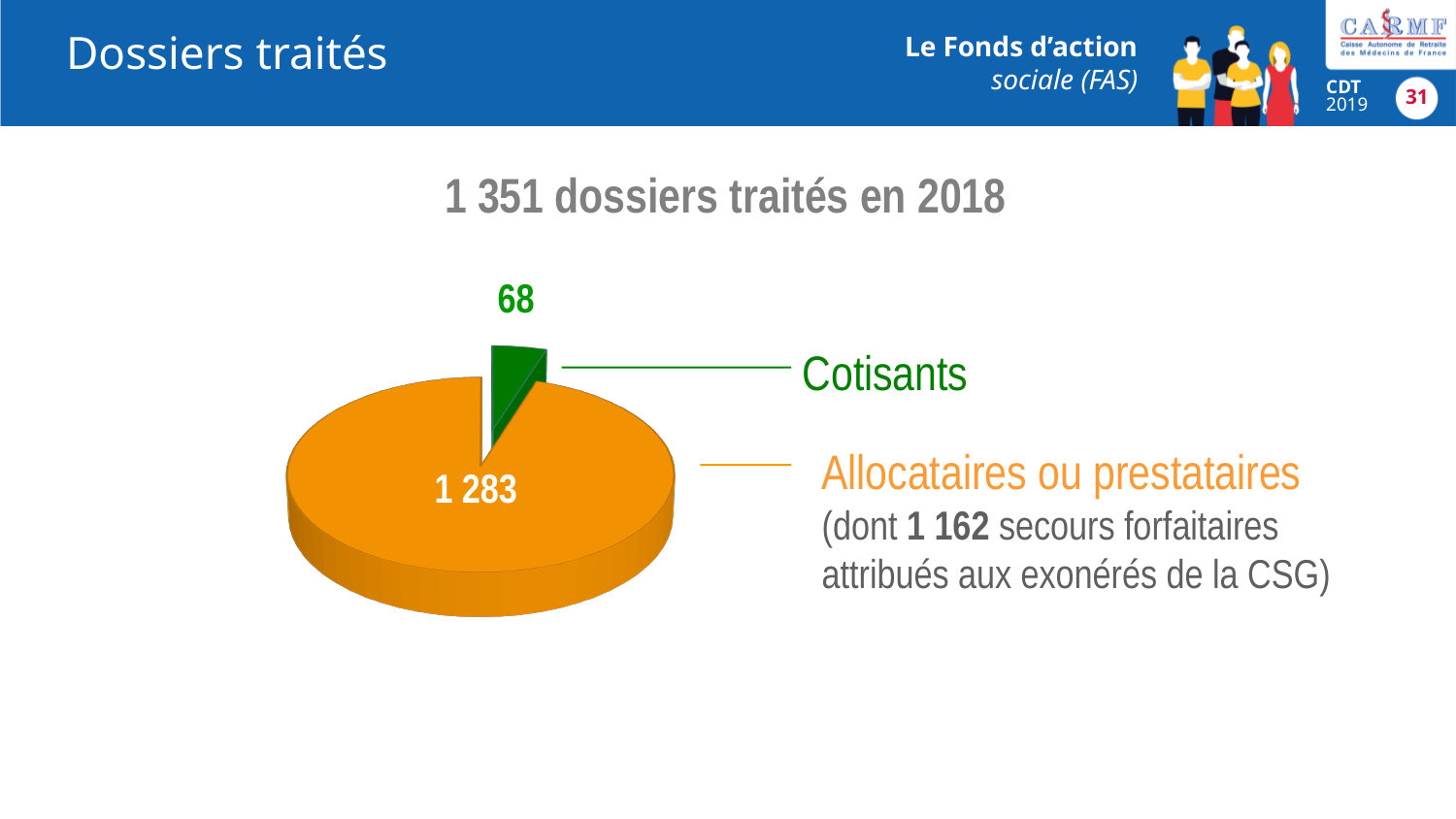
What is the value for Cotisants in the pie chart? 68 What is the difference between the Allocataires ou prestataires value and the Cotisants value? 1 215 What colour is the Allocataires ou prestataires slice in the pie chart? Orange Which slice of the pie chart is the smallest? Cotisants How many slices does the pie chart have? 2 What is the total of the two slices in the pie chart? 1 351 Which slice of the pie chart is the largest? Allocataires ou prestataires What kind of chart is shown on the slide? Pie chart What colour is the Cotisants slice in the pie chart? Green What is the value for Allocataires ou prestataires in the pie chart? 1 283 Which is larger, the value for Cotisants or the value for Allocataires ou prestataires? Allocataires ou prestataires